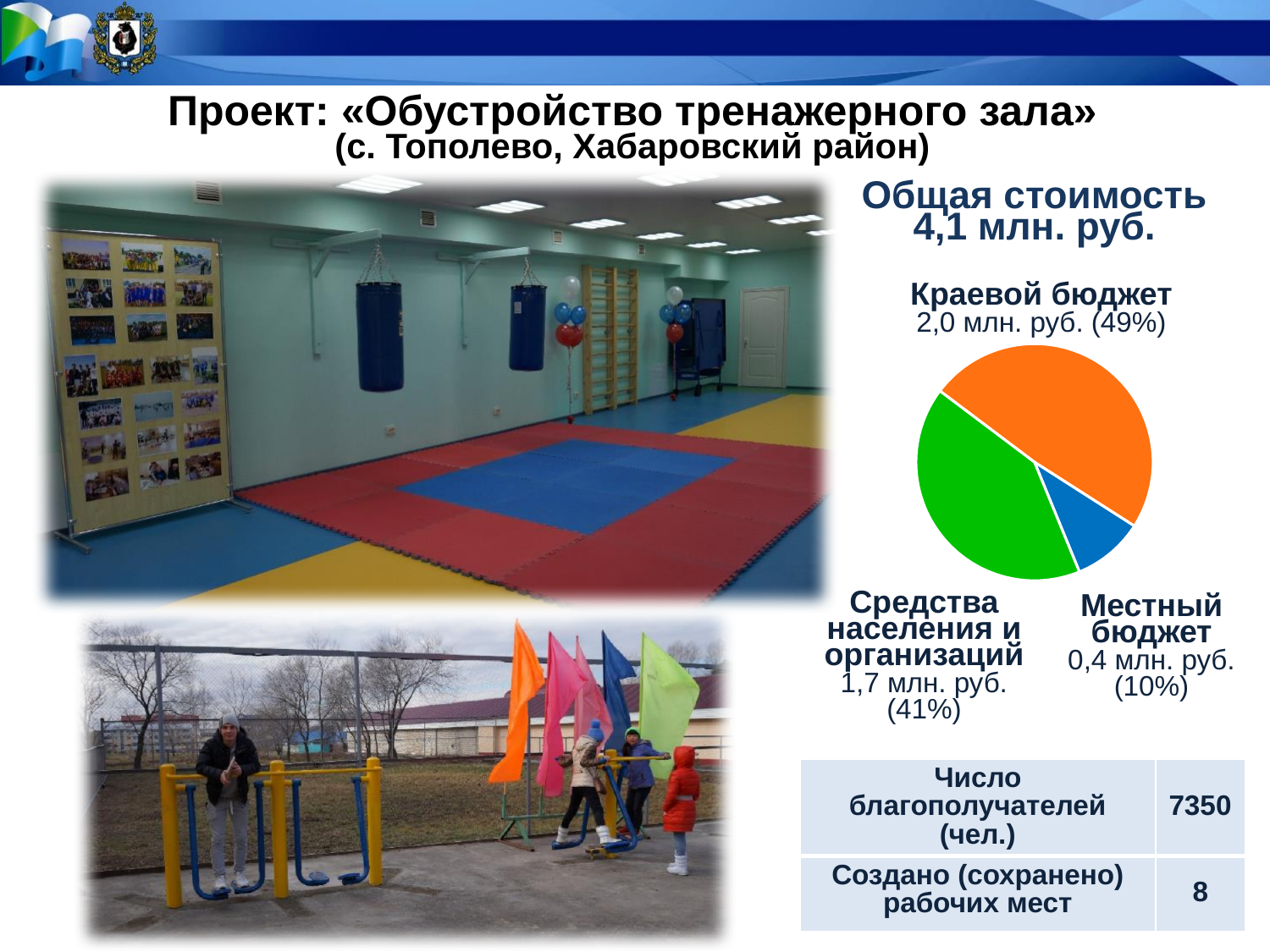
What share of the pie does Местный бюджет represent? 10% What is the value for Местный бюджет in the pie chart? 0,4 млн. руб. How many slices does the pie chart have? 3 Which is larger, Краевой бюджет or Средства населения и организаций? Краевой бюджет What is the value for Средства населения и организаций in the pie chart? 1,7 млн. руб. Which funding source has the largest share of the pie chart? Краевой бюджет Which funding source has the smallest share of the pie chart? Местный бюджет What share of the pie does Средства населения и организаций represent? 41% What is the total cost (Общая стоимость) shown above the pie chart? 4,1 млн. руб. What kind of chart is shown on the slide? pie chart What is the value for Краевой бюджет in the pie chart? 2,0 млн. руб. What is the difference in млн. руб. between Краевой бюджет and Местный бюджет? 1,6 млн. руб.